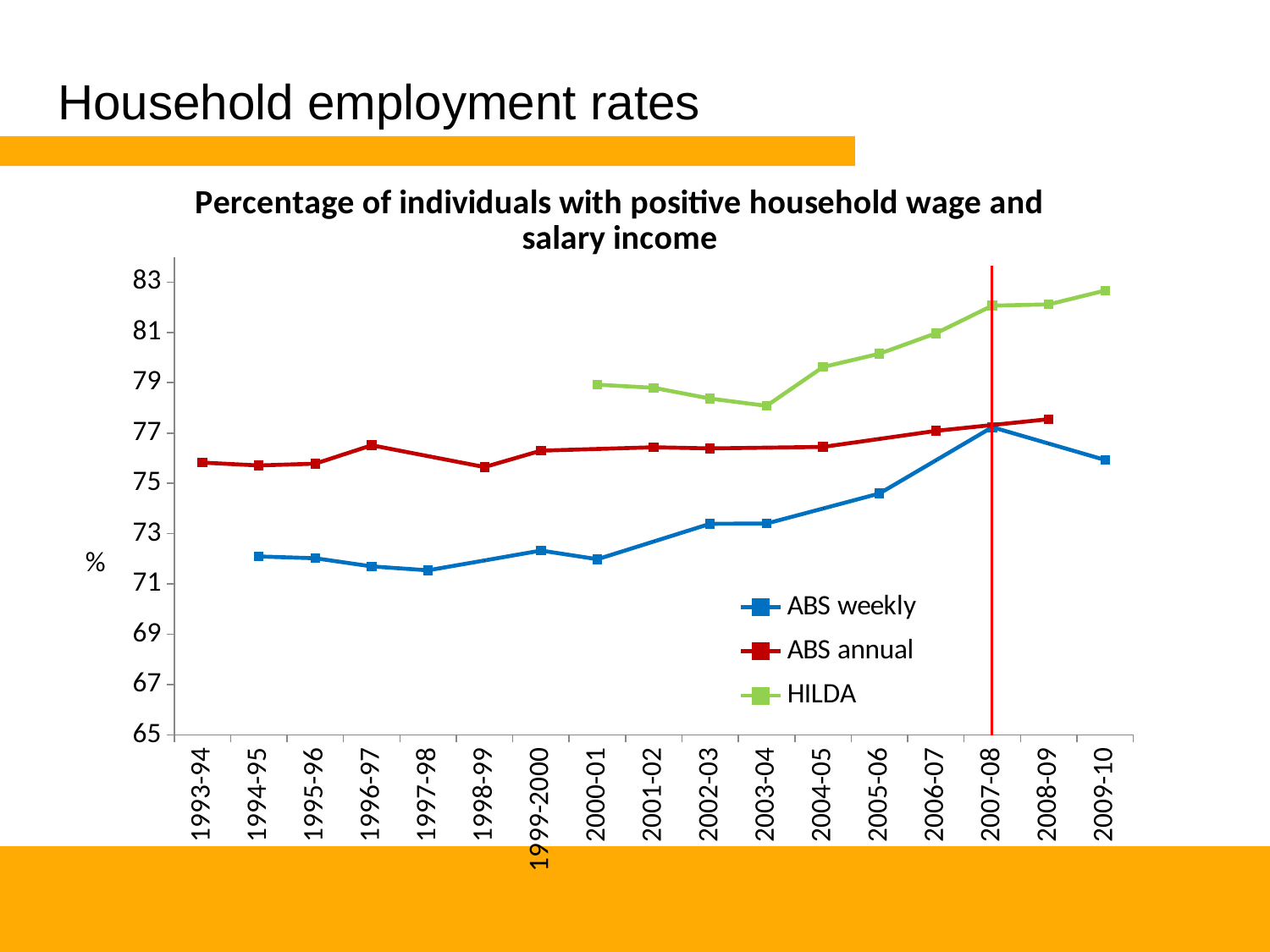
Which series begins in 2000-01 rather than at the start of the x axis? HILDA What is the title of the chart? Percentage of individuals with positive household wage and salary income Is the value for ABS weekly in 2005-06 greater or less than 75? less Is the value for ABS weekly in 1997-98 greater or less than 71? greater How many series does the legend list? 3 How many financial years are shown on the x axis? 17 Does the ABS weekly series rise or fall between 2007-08 and 2009-10? fall Is the value for HILDA in 2003-04 greater or less than 79? less What kind of chart is shown on the slide? line chart In which year does the HILDA series reach its highest value? 2009-10